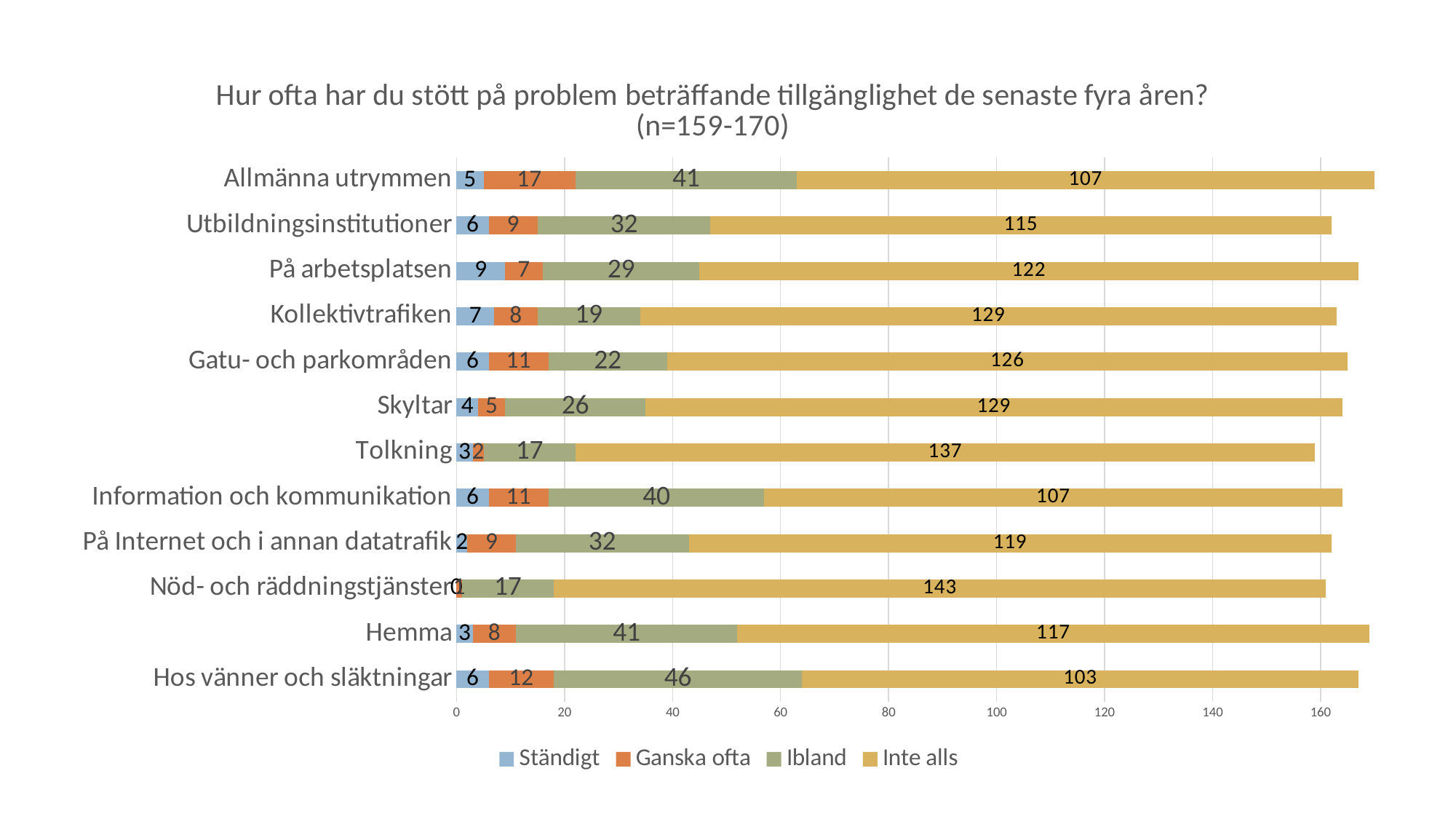
How many series does the legend list? 4 What kind of chart is shown on the slide? Stacked bar chart Which category has the highest "Inte alls" value? Nöd- och räddningstjänster What is the difference between the "Inte alls" values for Kollektivtrafiken and Allmänna utrymmen? 22 What are the four legend entries of the chart? Ständigt, Ganska ofta, Ibland, Inte alls What is the value of "Inte alls" for Tolkning? 137 How many categories are shown on the y axis? 12 Which category has the lowest "Inte alls" value? Hos vänner och släktningar What is the total of the stacked bar for Allmänna utrymmen? 170 What is the value of "Ibland" for Hos vänner och släktningar? 46 Which has a larger "Ibland" value: Information och kommunikation or Hos vänner och släktningar? Hos vänner och släktningar What is the value of "Ständigt" for På arbetsplatsen? 9